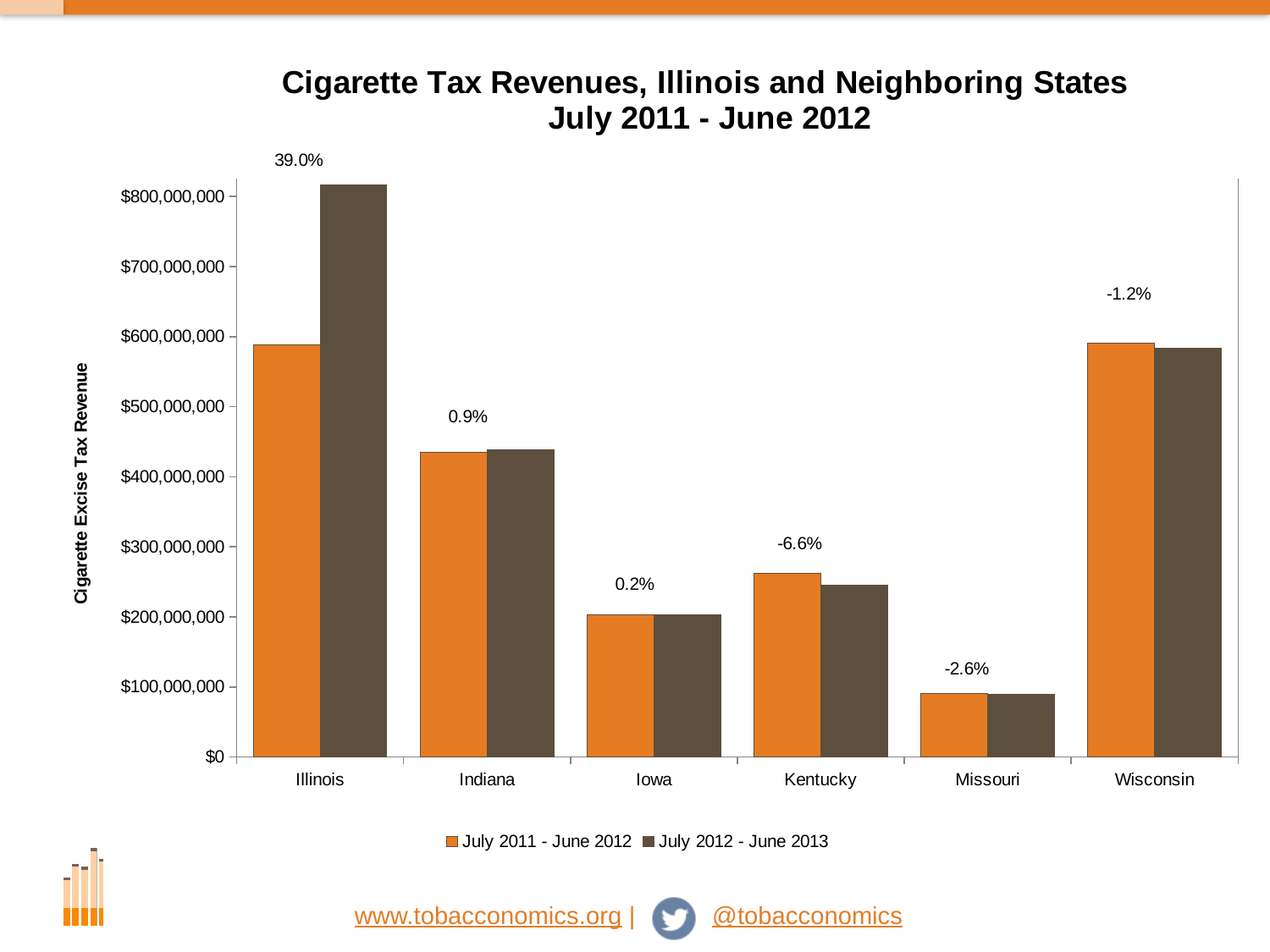
Which is larger for July 2011 - June 2012: the value for Kentucky or the value for Iowa? Kentucky How many series does the chart's legend list? 2 Is the July 2011 - June 2012 value for Missouri greater or less than $100,000,000? less What percentage change is printed above the Kentucky bars? -6.6% Which state has the lowest cigarette tax revenue for July 2011 - June 2012? Missouri What percentage change is printed above the Missouri bars? -2.6% What kind of chart is shown on the slide? bar chart What is the label on the y axis of the chart? Cigarette Excise Tax Revenue How many states are shown on the x axis of the chart? 6 Is the July 2012 - June 2013 value for Illinois greater or less than $800,000,000? greater Which state has the highest cigarette tax revenue for July 2012 - June 2013? Illinois What percentage change is printed above the Illinois bars? 39.0%